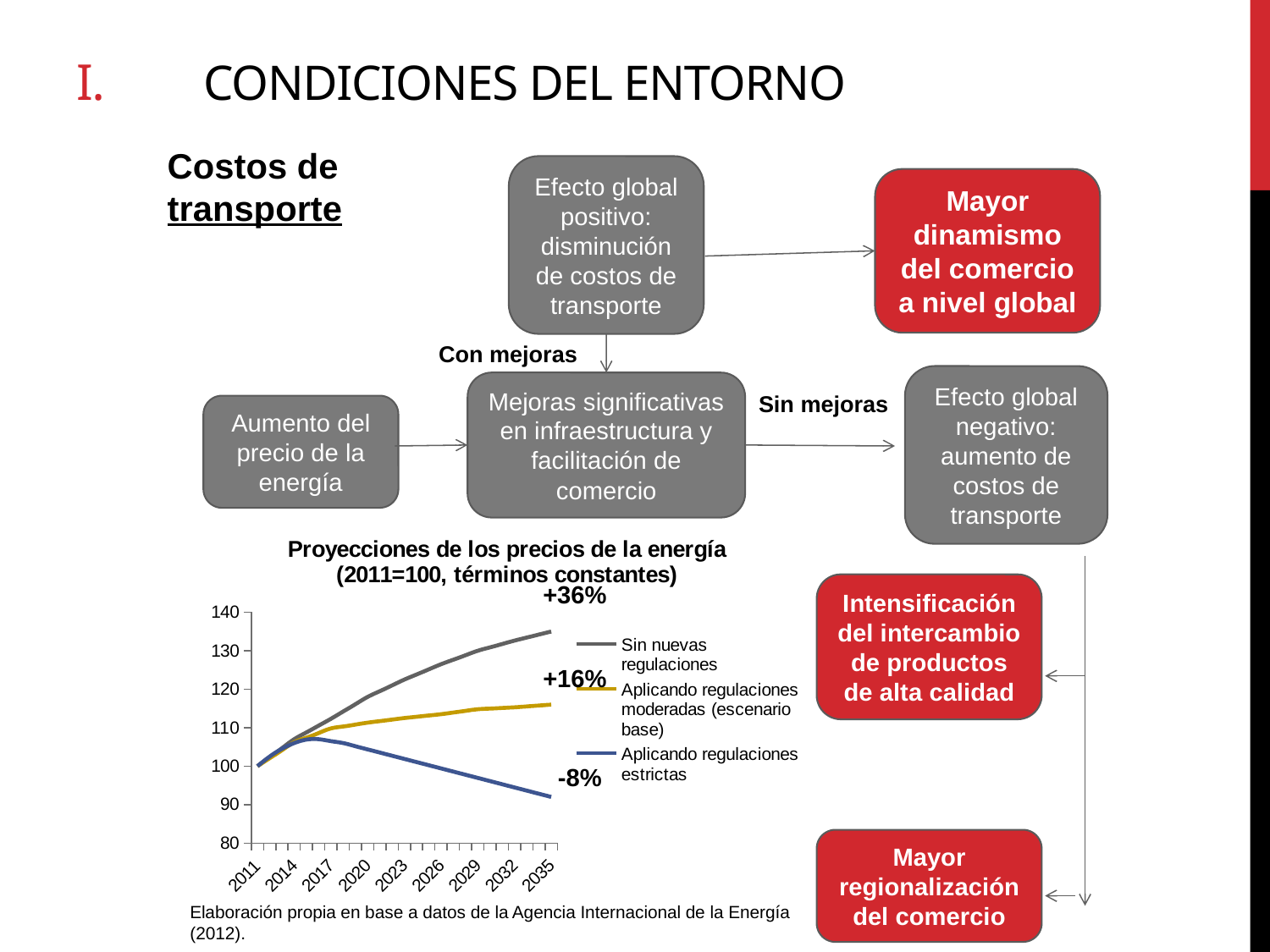
What percentage change is annotated for the 'Aplicando regulaciones estrictas' series? -8% Which series has the highest value in 2035? Sin nuevas regulaciones Which series has the lowest value in 2035? Aplicando regulaciones estrictas What percentage change is annotated for the 'Sin nuevas regulaciones' series? +36% What percentage change is annotated for the 'Aplicando regulaciones moderadas (escenario base)' series? +16% How many year labels are shown on the x axis? 9 Is the value for 'Sin nuevas regulaciones' in 2035 greater or less than 130? greater How many series does the chart legend list? 3 Is the value for 'Aplicando regulaciones estrictas' in 2035 greater or less than 100? less What kind of chart is shown on the slide? line chart Does the 'Sin nuevas regulaciones' series rise or fall from 2011 to 2035? rise What is the title of the chart? Proyecciones de los precios de la energía (2011=100, términos constantes)